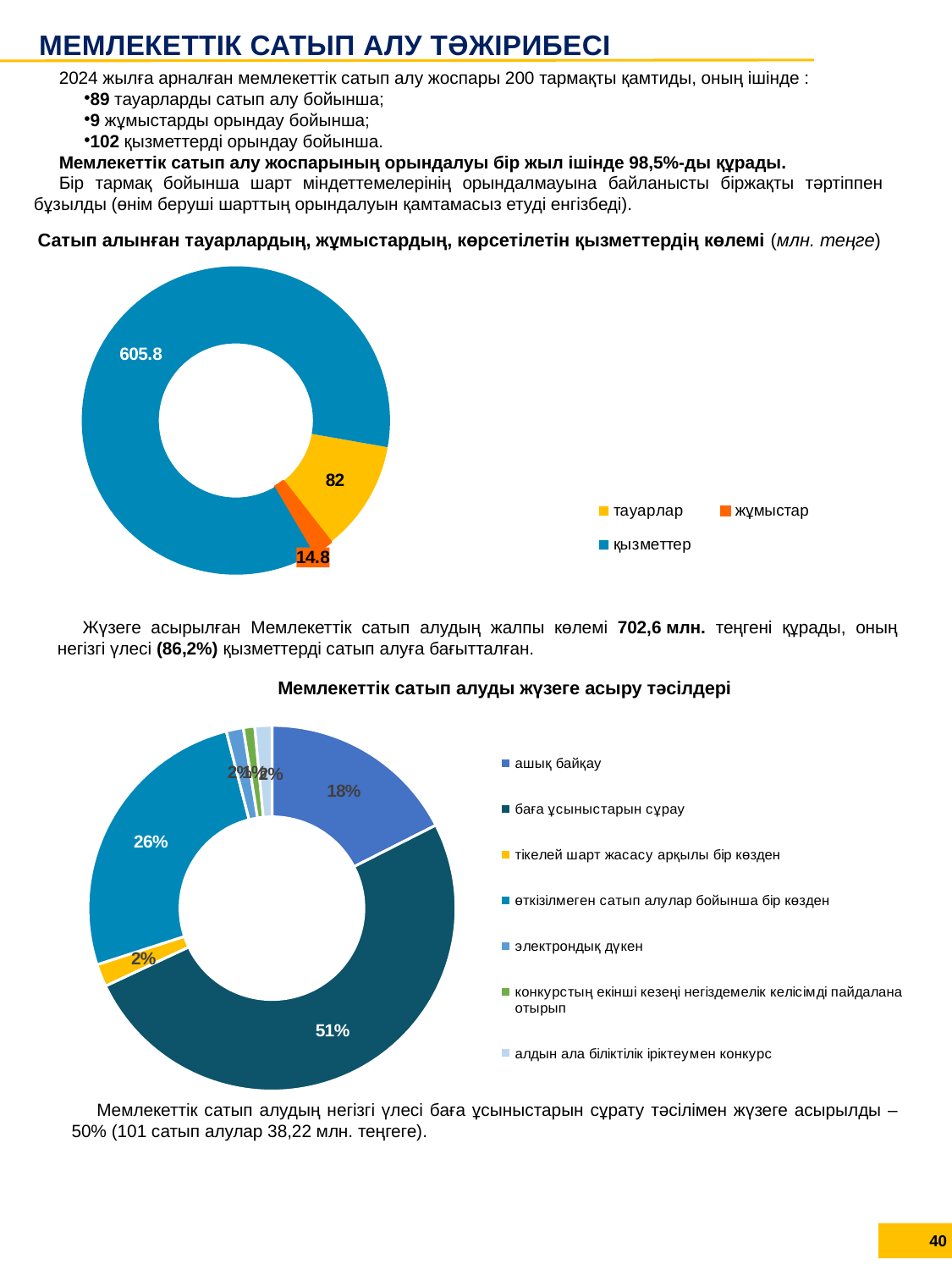
In the top chart (Сатып алынған тауарлардың, жұмыстардың, көрсетілетін қызметтердің көлемі), which category has the largest value? қызметтер In the bottom chart (Мемлекеттік сатып алуды жүзеге асыру тәсілдері), how many categories does the legend list? 7 In the bottom chart (Мемлекеттік сатып алуды жүзеге асыру тәсілдері), what share is shown for ашық байқау? 18% What type of chart is the top chart (Сатып алынған тауарлардың, жұмыстардың, көрсетілетін қызметтердің көлемі)? Doughnut (pie) chart In the top chart (Сатып алынған тауарлардың, жұмыстардың, көрсетілетін қызметтердің көлемі), what is the difference between the values for тауарлар and жұмыстар? 67.2 In the top chart (Сатып алынған тауарлардың, жұмыстардың, көрсетілетін қызметтердің көлемі), which category has the smallest value? жұмыстар In the top chart (Сатып алынған тауарлардың, жұмыстардың, көрсетілетін қызметтердің көлемі), how many categories does the legend list? 3 In the bottom chart (Мемлекеттік сатып алуды жүзеге асыру тәсілдері), what share is shown for баға ұсыныстарын сұрау? 51% In the top chart (Сатып алынған тауарлардың, жұмыстардың, көрсетілетін қызметтердің көлемі), what is the value for тауарлар? 82 In the bottom chart (Мемлекеттік сатып алуды жүзеге асыру тәсілдері), which category has the largest share? баға ұсыныстарын сұрау In the top chart (Сатып алынған тауарлардың, жұмыстардың, көрсетілетін қызметтердің көлемі), what is the value for қызметтер? 605.8 In the top chart (Сатып алынған тауарлардың, жұмыстардың, көрсетілетін қызметтердің көлемі), what is the value for жұмыстар? 14.8